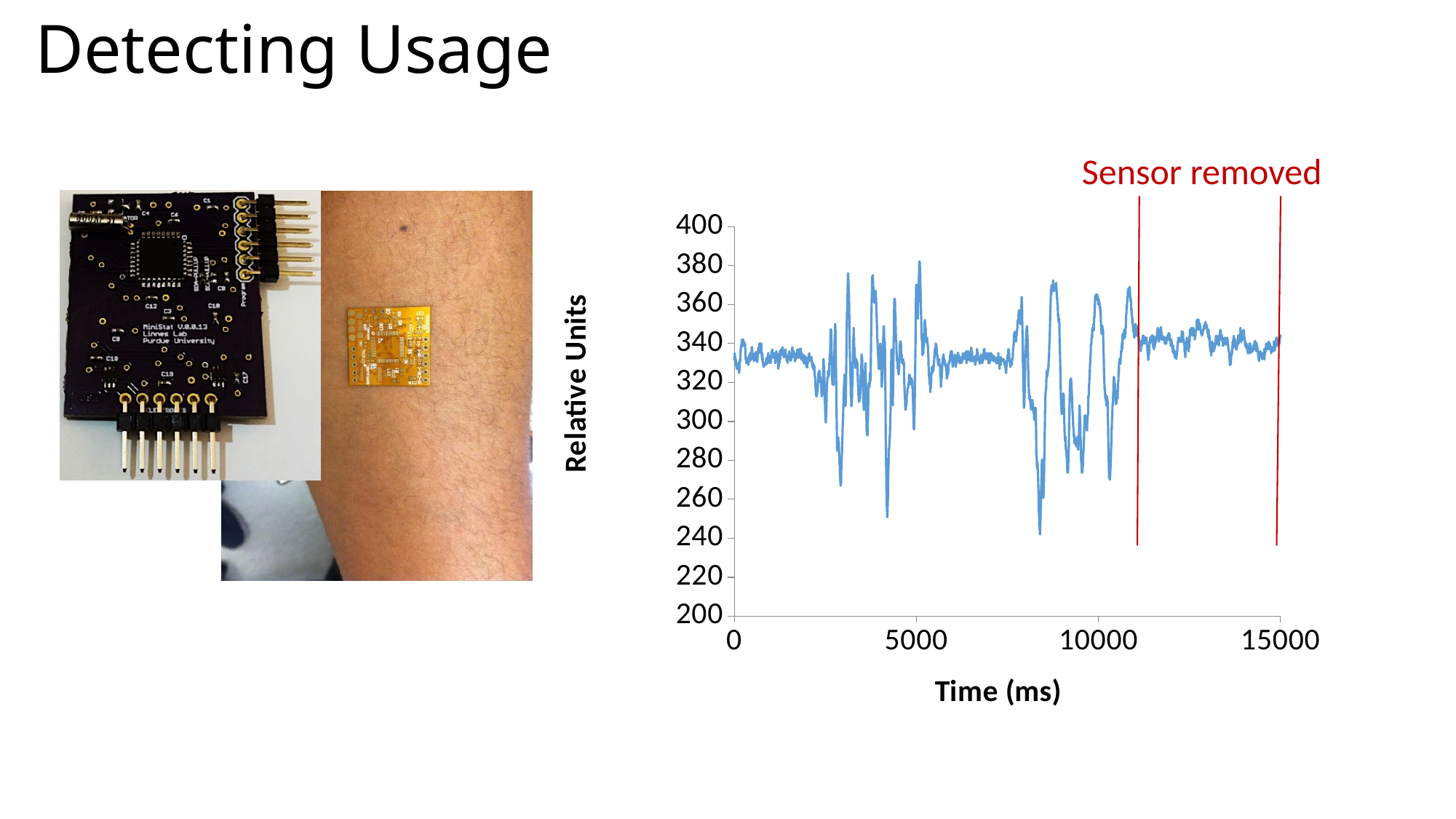
What is the minimum value shown on the y axis of the chart? 200 How many data series are plotted on the chart? 1 What is the largest tick value shown on the x axis of the chart? 15000 Is the signal value at time 15000 greater or less than 320? greater What is the label of the y axis of the chart? Relative Units Is the lowest point of the signal greater or less than 260? less Is the highest point of the signal greater or less than 360? greater What kind of chart is shown on the slide? line chart